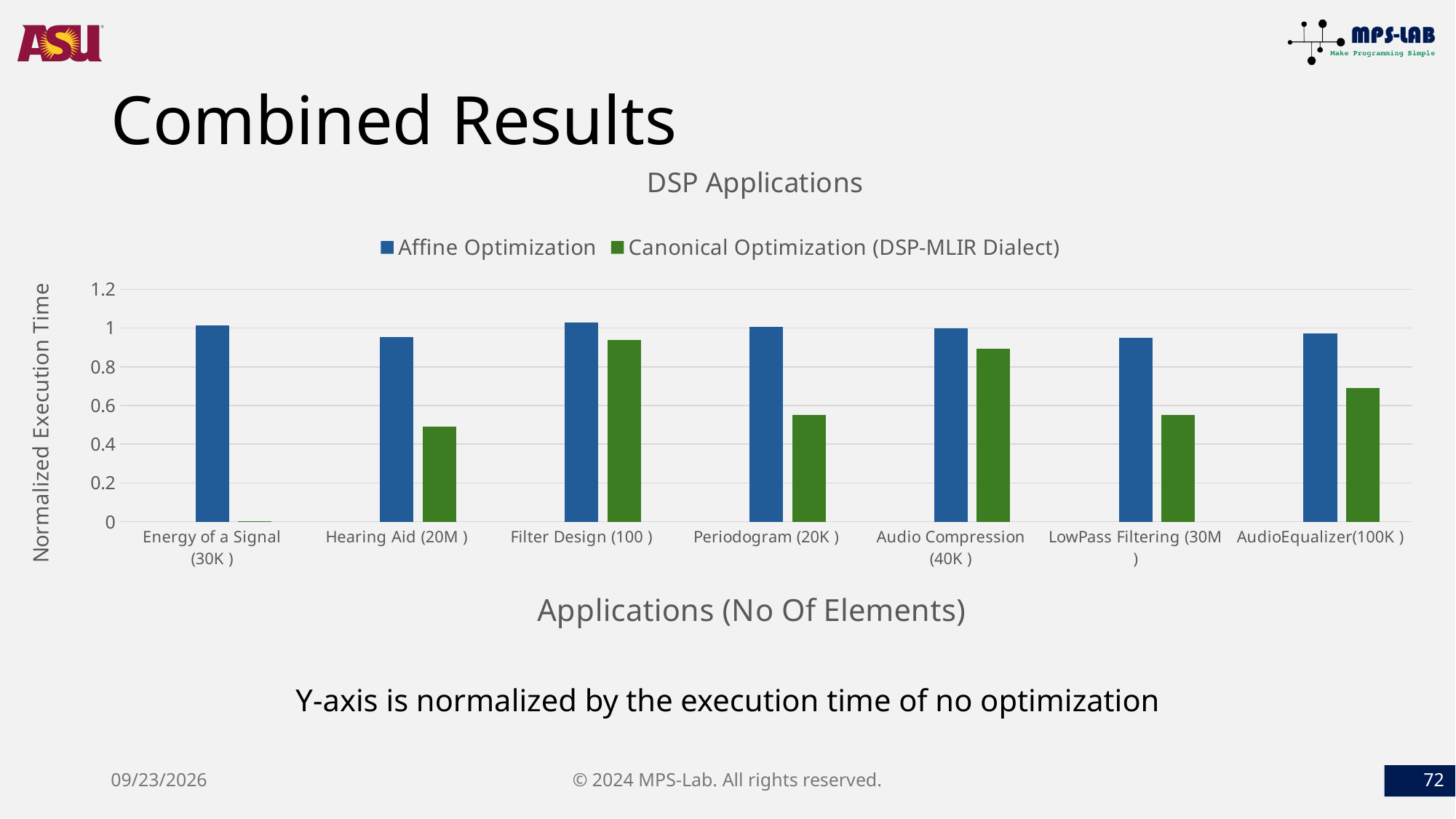
What is the title of the chart? DSP Applications Is the Canonical Optimization (DSP-MLIR Dialect) value for Energy of a Signal (30K ) greater or less than 0.2? less Which application has the lowest Canonical Optimization (DSP-MLIR Dialect) value? Energy of a Signal (30K ) Which application has the highest Canonical Optimization (DSP-MLIR Dialect) value? Filter Design (100 ) How many series does the legend list? 2 For Hearing Aid (20M ), which is larger: the Affine Optimization value or the Canonical Optimization (DSP-MLIR Dialect) value? Affine Optimization Is the Canonical Optimization (DSP-MLIR Dialect) value for AudioEqualizer(100K ) greater or less than 0.6? greater Is the Canonical Optimization (DSP-MLIR Dialect) value for Audio Compression (40K ) greater or less than 0.8? greater What is the label of the y axis? Normalized Execution Time How many applications (categories) are shown on the x axis? 7 What kind of chart is shown on the slide? bar chart